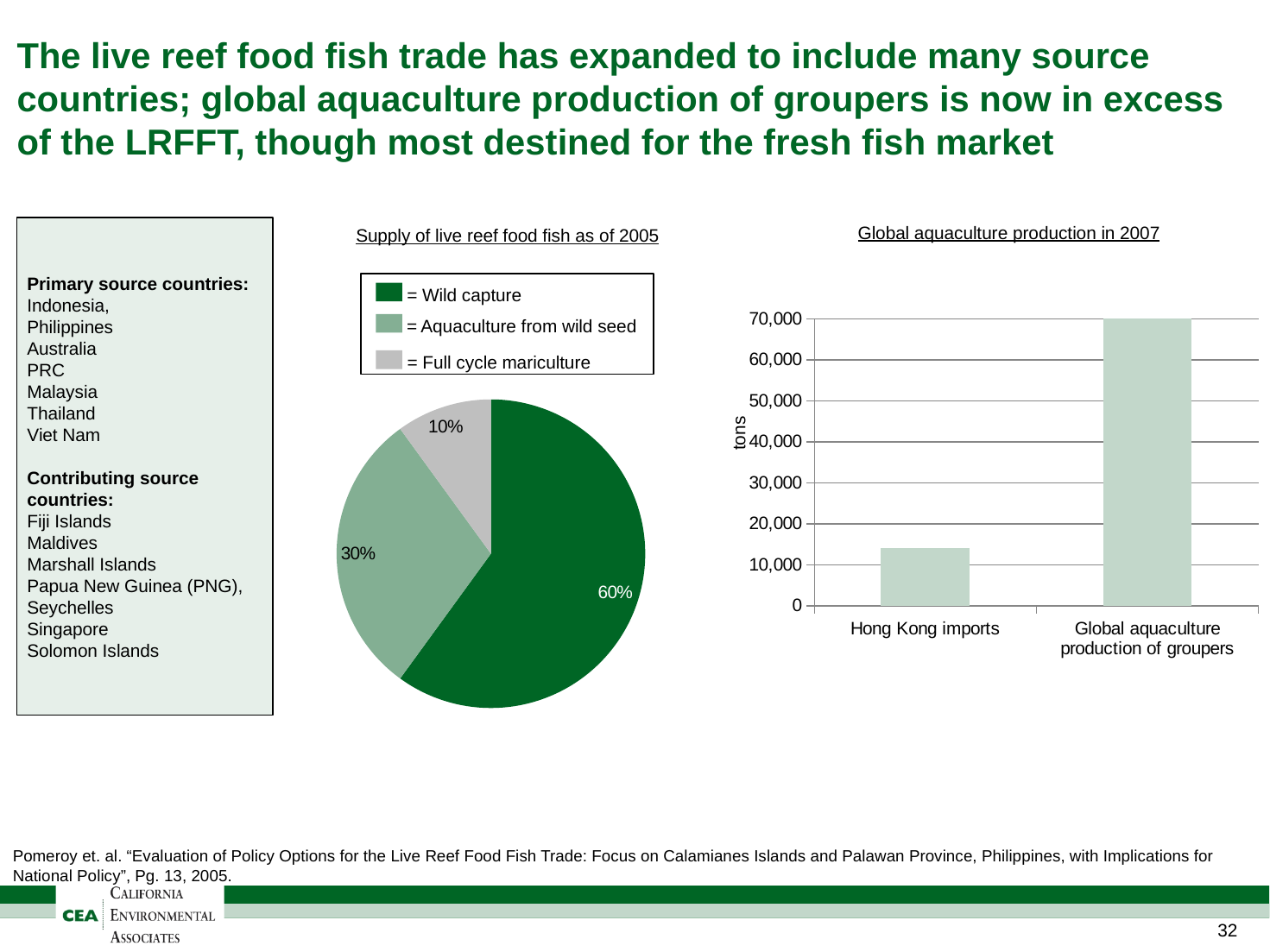
In the 'Supply of live reef food fish as of 2005' chart, which category has the largest share? Wild capture In the 'Supply of live reef food fish as of 2005' chart, which category has the smallest share? Full cycle mariculture In the 'Supply of live reef food fish as of 2005' chart, what share of supply is full cycle mariculture? 10% In the 'Supply of live reef food fish as of 2005' chart, how many percentage points larger is wild capture than aquaculture from wild seed? 30 percentage points How many categories does the legend of the 'Supply of live reef food fish as of 2005' chart list? 3 How many bars are shown in the 'Global aquaculture production in 2007' chart? 2 What kind of chart is 'Global aquaculture production in 2007'? Bar chart In the 'Supply of live reef food fish as of 2005' chart, what share of supply is wild capture? 60% In the 'Supply of live reef food fish as of 2005' chart, what share of supply is aquaculture from wild seed? 30% In the 'Global aquaculture production in 2007' chart, is the value for Hong Kong imports greater or less than 20,000? less In the 'Global aquaculture production in 2007' chart, which category has the higher value? Global aquaculture production of groupers What kind of chart is 'Supply of live reef food fish as of 2005'? Pie chart